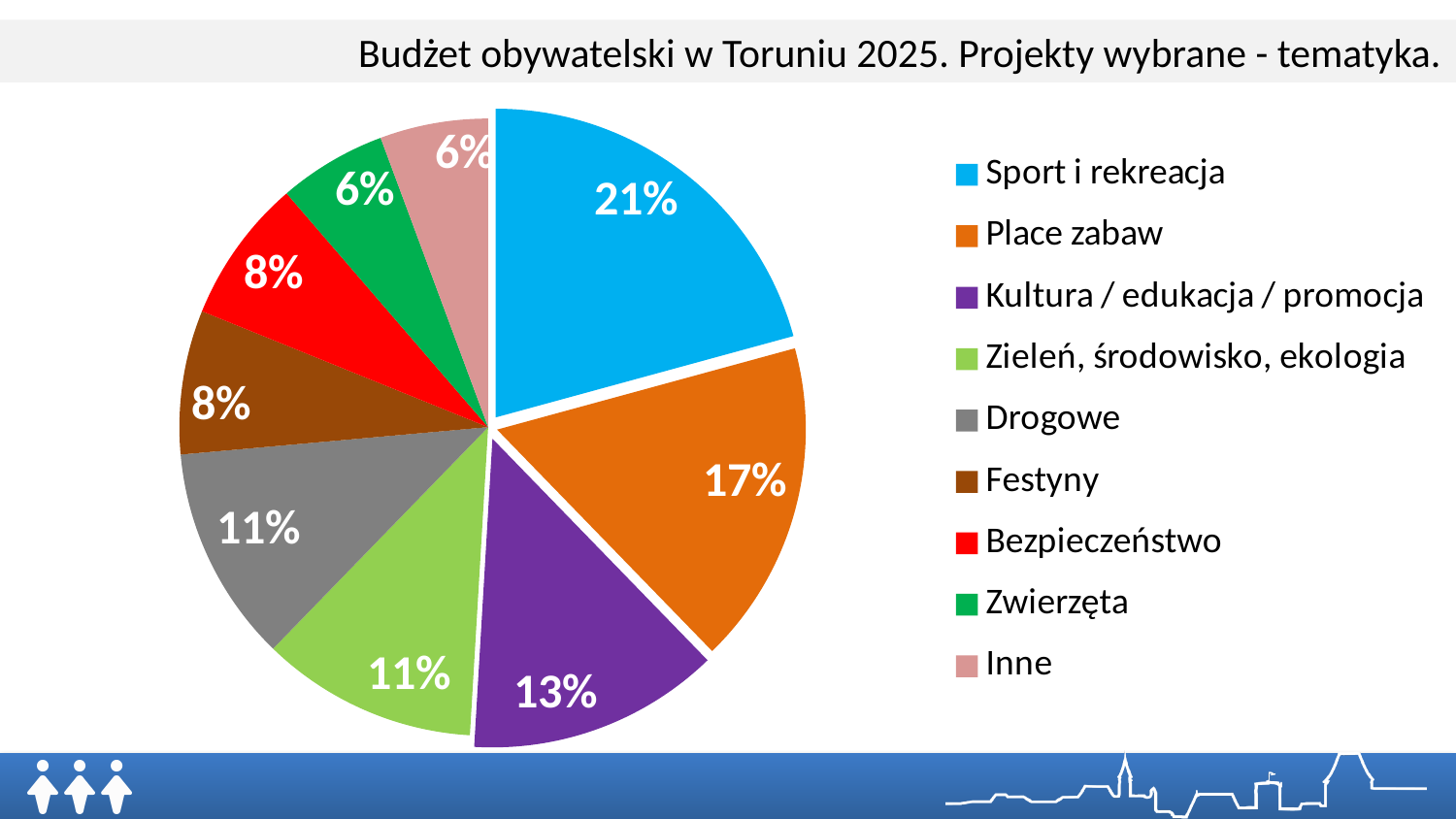
What percentage is shown for Kultura / edukacja / promocja? 13% What is the title of the chart? Budżet obywatelski w Toruniu 2025. Projekty wybrane - tematyka. Which category has the largest share of the pie? Sport i rekreacja How many categories does the pie chart show? 9 What is the value for Zwierzęta? 6% What type of chart is shown on the slide? Pie chart What share of the pie does Sport i rekreacja represent? 21% What is the difference in percentage points between Sport i rekreacja and Place zabaw? 4 Which is larger, the share for Place zabaw or the share for Festyny? Place zabaw What is the value shown for Place zabaw? 17% What percentage is shown for Bezpieczeństwo? 8% What is the value for Drogowe? 11%